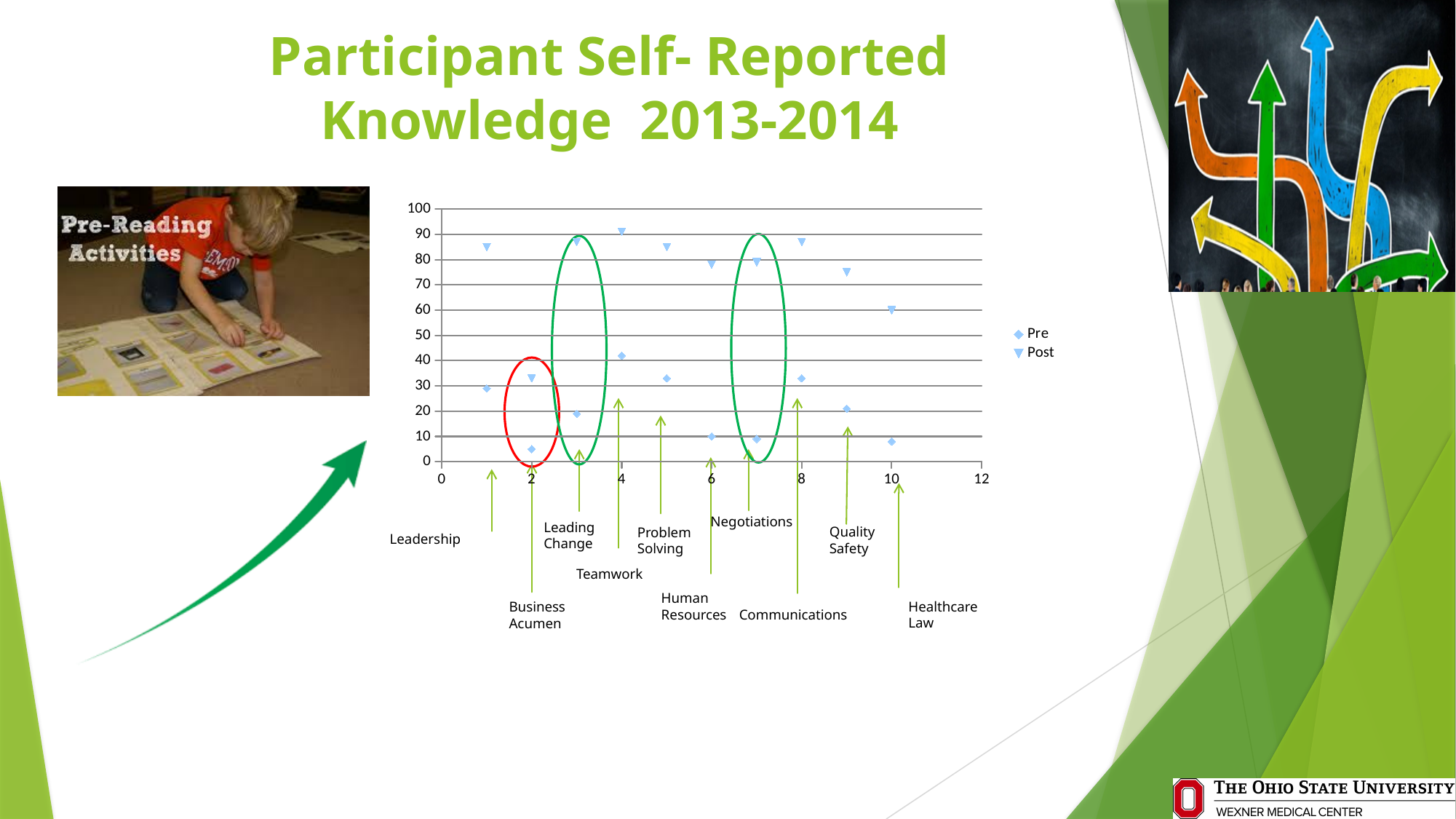
What are the two series named in the chart legend? Pre and Post Is the Post value for Healthcare Law greater or less than 70? less Which knowledge area has the lowest Pre value? Business Acumen Which is larger, the Post value for Leadership or the Post value for Healthcare Law? Leadership Is the Post value for Leadership greater or less than 80? greater How many knowledge areas are labelled along the x axis of the chart? 10 Which knowledge area has the highest Pre value? Teamwork Which knowledge area has the lowest Post value? Business Acumen How many series does the chart legend list? 2 What kind of chart is shown on the slide? scatter chart What colour is the oval drawn around the Business Acumen points on the chart? red Is the Pre value for Business Acumen greater or less than 10? less